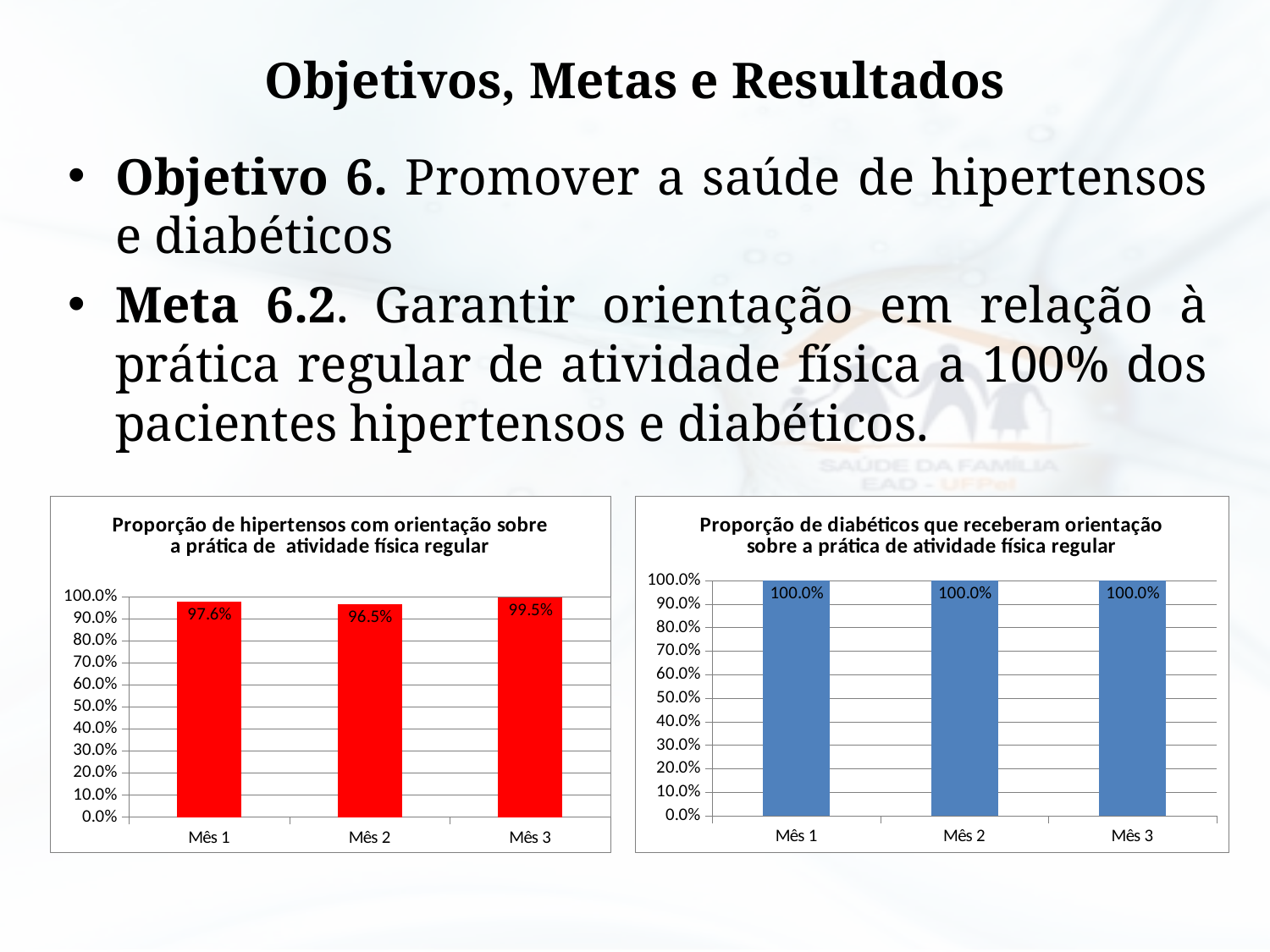
In the left chart (Proporção de hipertensos com orientação sobre a prática de atividade física regular), which month has the highest value? Mês 3 In the left chart (Proporção de hipertensos com orientação sobre a prática de atividade física regular), what is the value for Mês 3? 99.5% In the left chart (Proporção de hipertensos com orientação sobre a prática de atividade física regular), what is the difference between the values for Mês 3 and Mês 2? 3.0% In the left chart (Proporção de hipertensos com orientação sobre a prática de atividade física regular), what is the value for Mês 2? 96.5% In the right chart (Proporção de diabéticos que receberam orientação sobre a prática de atividade física regular), how many months are plotted? 3 In the right chart (Proporção de diabéticos que receberam orientação sobre a prática de atividade física regular), do the values change from Mês 1 to Mês 3? No, they stay at 100.0% In the left chart (Proporção de hipertensos com orientação sobre a prática de atividade física regular), what is the value for Mês 1? 97.6% What kind of chart is the left chart (Proporção de hipertensos com orientação sobre a prática de atividade física regular)? Bar chart In the left chart (Proporção de hipertensos com orientação sobre a prática de atividade física regular), which month has the lowest value? Mês 2 In the right chart (Proporção de diabéticos que receberam orientação sobre a prática de atividade física regular), what is the value for Mês 2? 100.0% What colour are the bars in the left chart (Proporção de hipertensos com orientação sobre a prática de atividade física regular)? Red In the left chart (Proporção de hipertensos com orientação sobre a prática de atividade física regular), which is larger, the value for Mês 1 or Mês 2? Mês 1